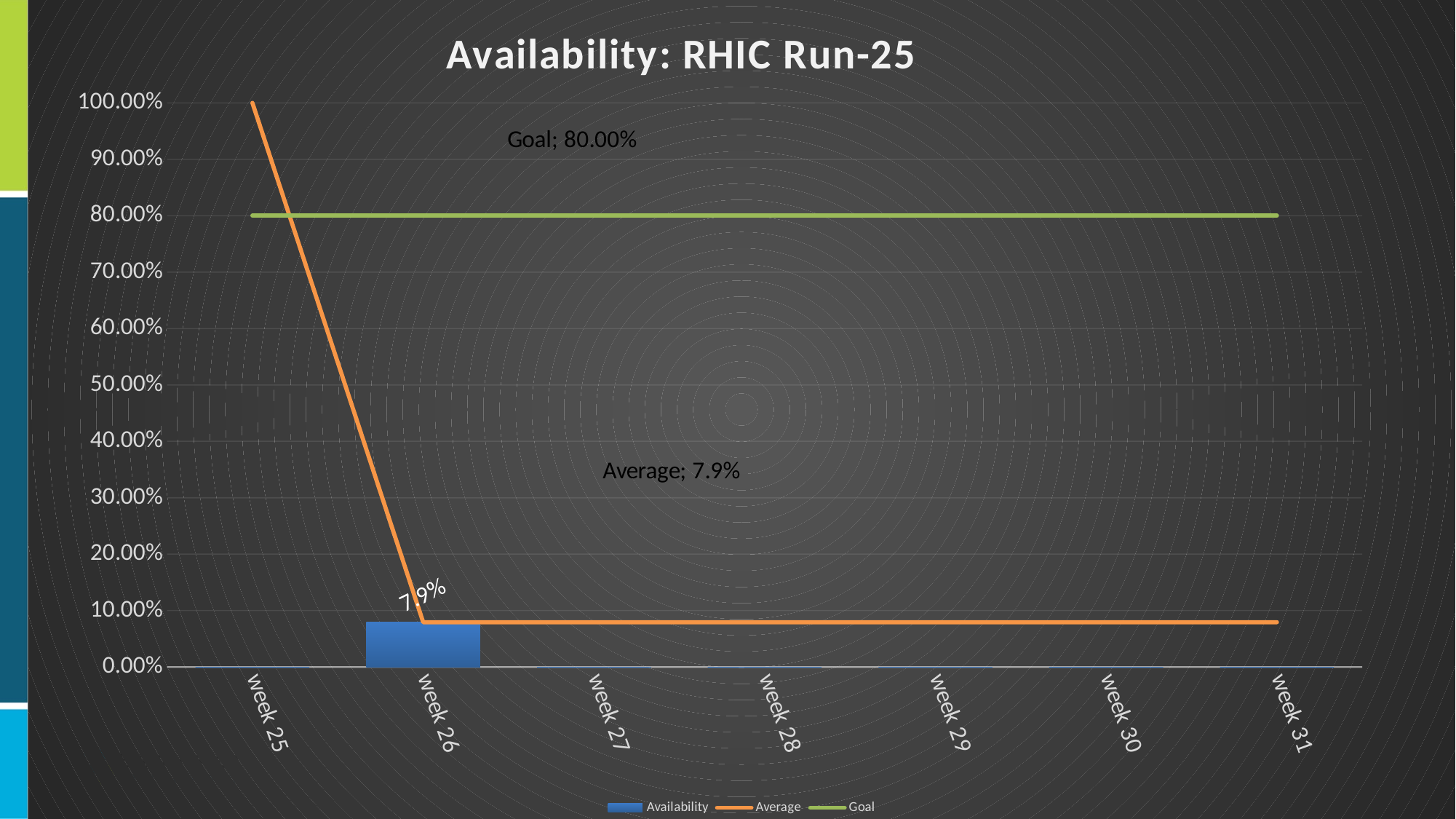
Which is larger, the Goal value or the Average value? Goal How many series does the legend list? 3 What is the Availability value for week 26? 7.9% Does the Average line rise or fall from week 25 to week 26? fall What is the title of the chart? Availability: RHIC Run-25 What is the difference between the Goal value and the Average value? 72.1% What is the Average value labelled on the chart? 7.9% Is the Average line at week 25 greater or less than 90.00%? greater Which week has the highest Availability bar? week 26 What kind of chart is used to plot the Availability series? bar chart What value is the Goal line set at? 80.00% How many weeks are shown on the x axis? 7